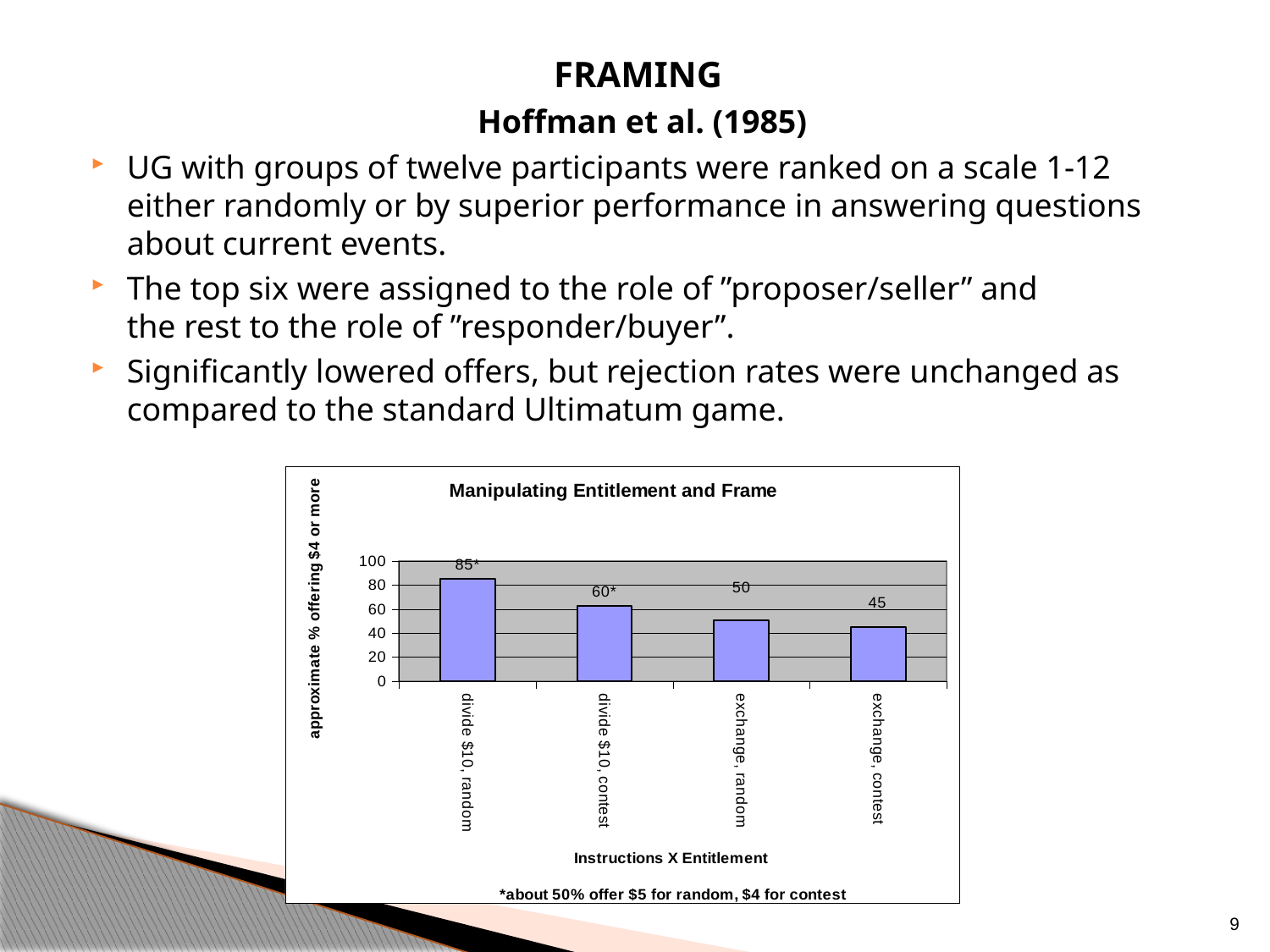
Do the values rise or fall moving from left to right along the x axis? fall What type of chart is shown on the slide? bar chart What value is labelled on the bar for 'exchange, contest'? 45 What value is labelled on the bar for 'divide $10, contest'? 60* What is the title of the chart? Manipulating Entitlement and Frame Which category has the highest value? divide $10, random How many categories (bars) does the chart show? 4 Which category has the lowest value? exchange, contest What value is labelled on the bar for 'divide $10, random'? 85* Which is larger, the value for 'divide $10, contest' or the value for 'exchange, random'? divide $10, contest What value is labelled on the bar for 'exchange, random'? 50 What is the difference between the values for 'exchange, random' and 'exchange, contest'? 5